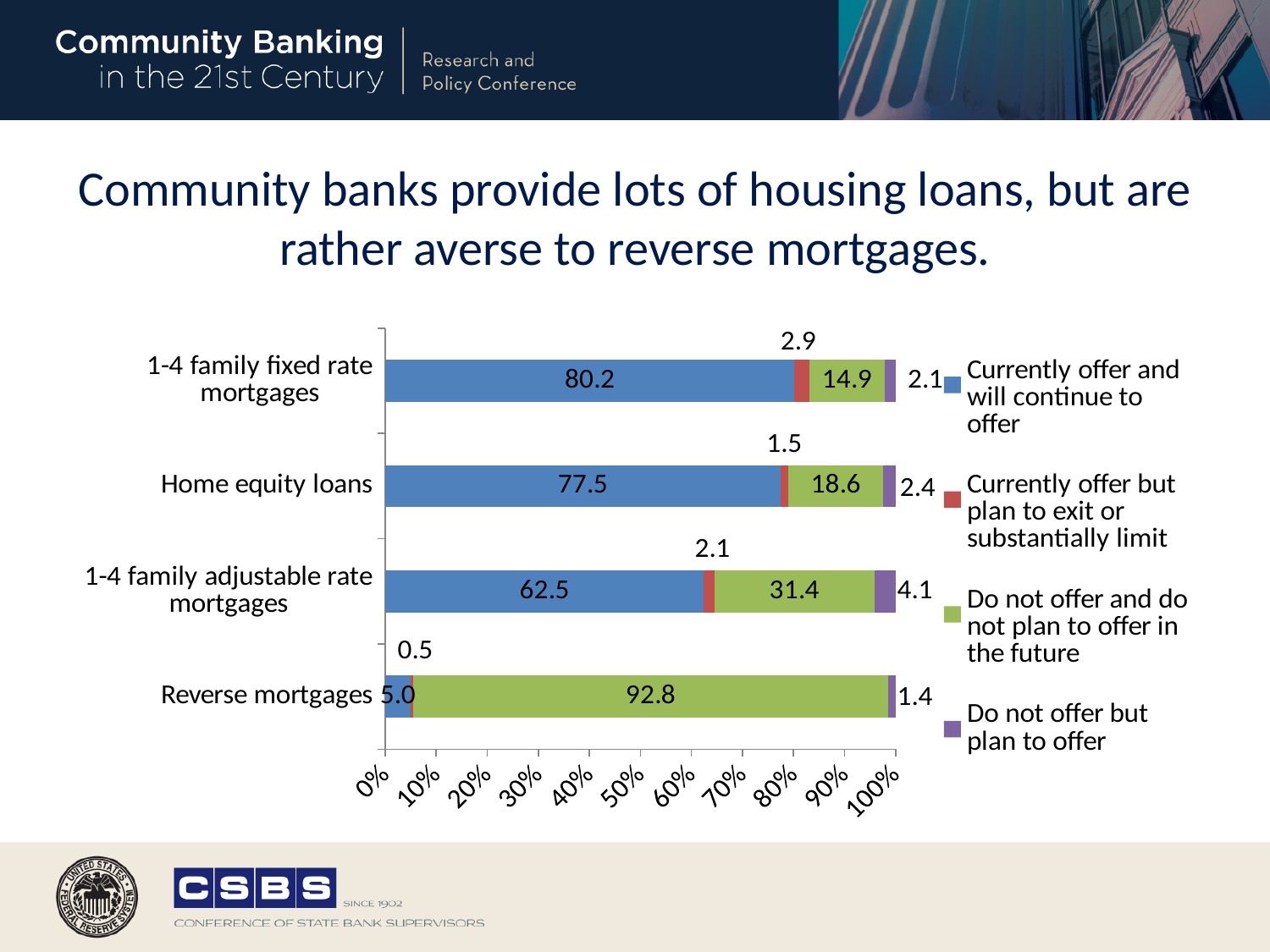
Which loan type has the highest value for 'Currently offer and will continue to offer'? 1-4 family fixed rate mortgages What percentage of community banks currently offer and will continue to offer 1-4 family fixed rate mortgages? 80.2 What is the value for 'Do not offer and do not plan to offer in the future' for reverse mortgages? 92.8 What is the value for 'Currently offer but plan to exit or substantially limit' for home equity loans? 1.5 What kind of chart is shown on the slide? Stacked bar chart Which is larger: the 'Do not offer and do not plan to offer in the future' value for home equity loans or for 1-4 family adjustable rate mortgages? 1-4 family adjustable rate mortgages Which colour represents 'Do not offer and do not plan to offer in the future' in the chart? Green How many series does the legend list? 4 What is the value for 'Do not offer but plan to offer' for 1-4 family adjustable rate mortgages? 4.1 Which loan type has the lowest value for 'Currently offer and will continue to offer'? Reverse mortgages What is the difference between the 'Currently offer and will continue to offer' values for 1-4 family fixed rate mortgages and home equity loans? 2.7 How many loan types are shown on the chart? 4